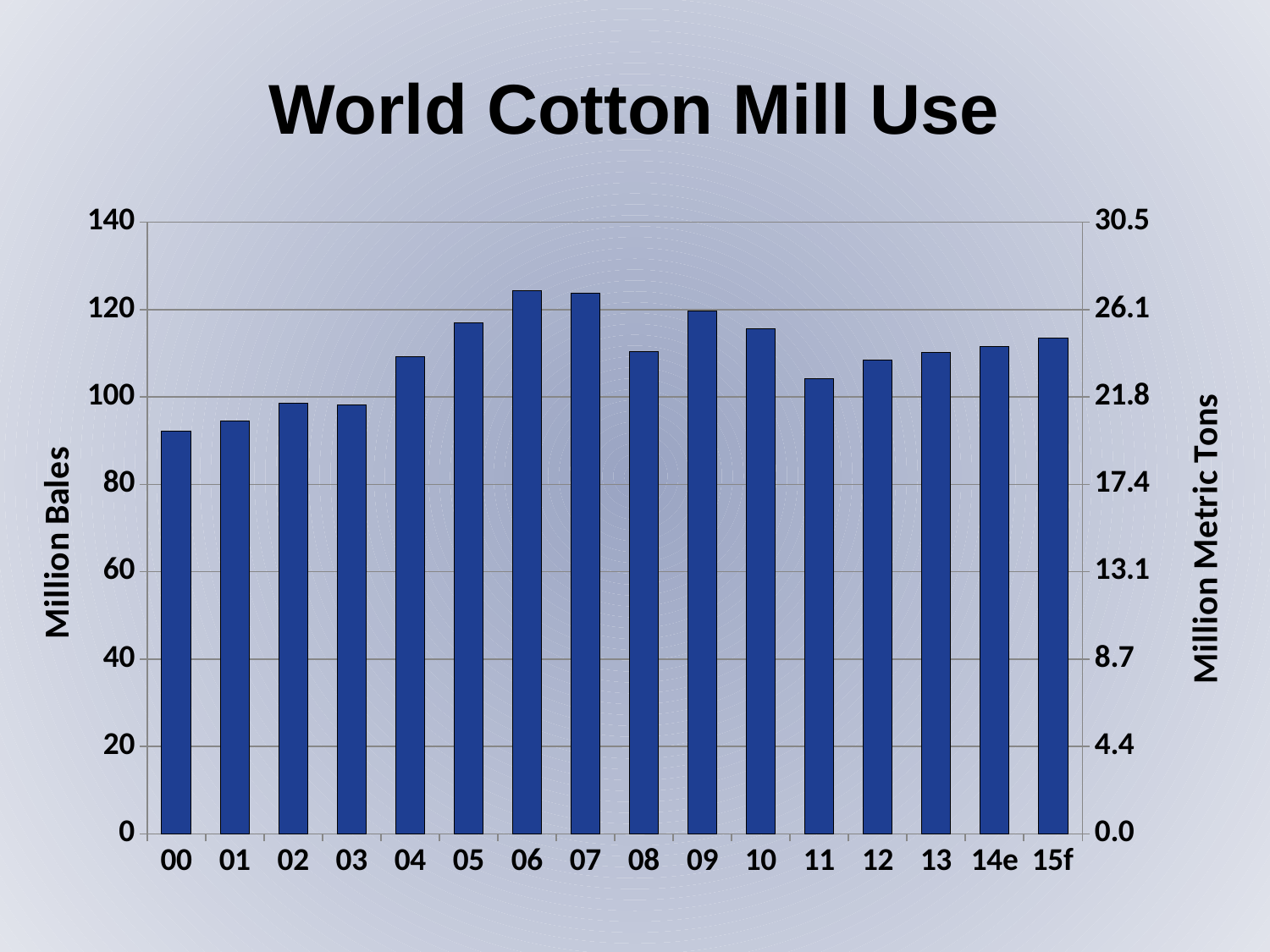
What is the title of the chart? World Cotton Mill Use Which year has the lowest cotton mill use? 00 What is the label of the left vertical axis? Million Bales Do the values generally rise or fall from 00 to 06? rise What type of chart is shown on the slide? bar chart Is the value for 11 greater or less than 100 million bales? greater Is the value for 06 greater or less than 120 million bales? greater Is the value for 00 greater or less than 100 million bales? less How many bars (years) are plotted on the chart? 16 Which year has the larger value, 04 or 05? 05 Which year has the larger value, 09 or 10? 09